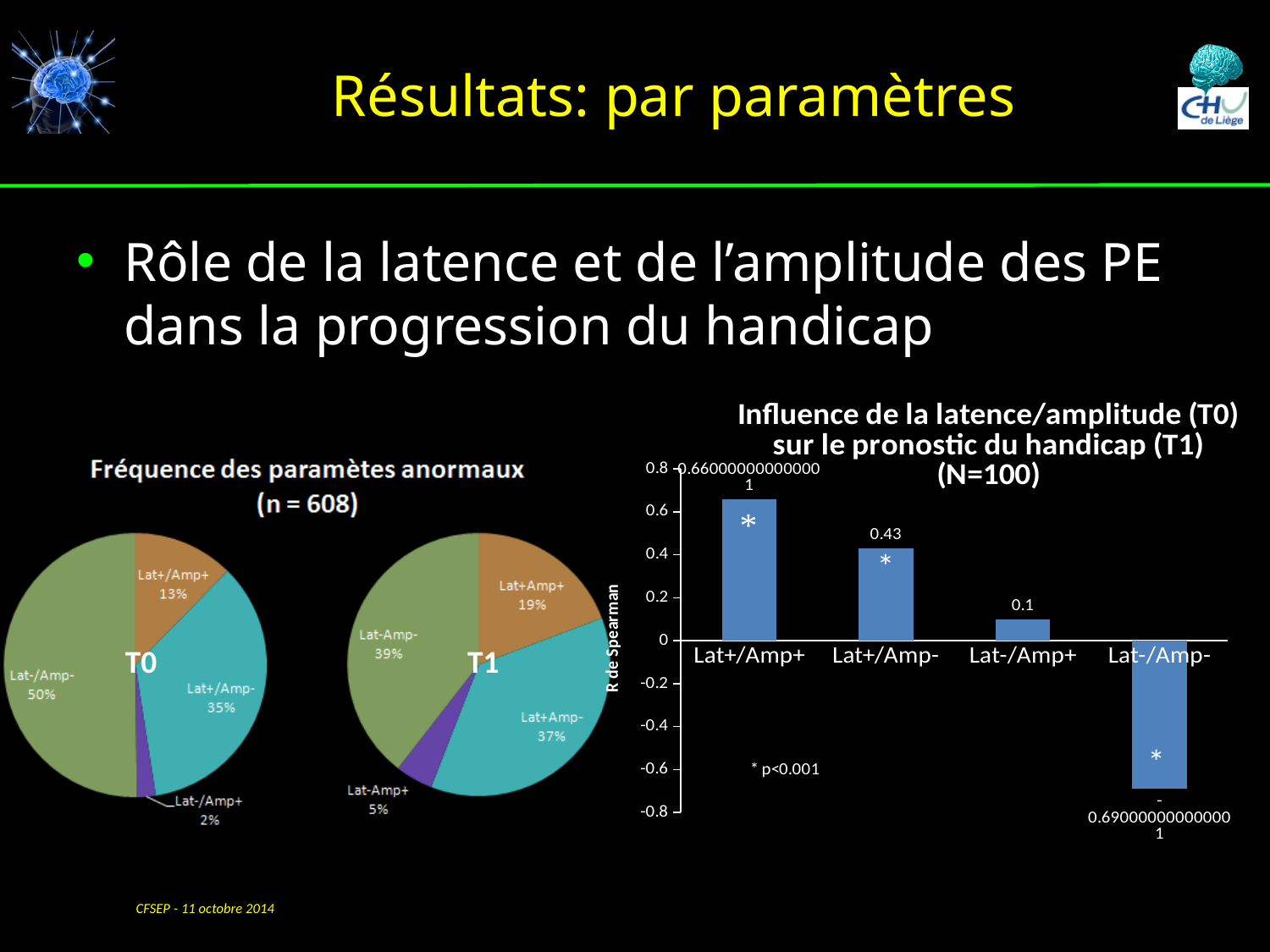
In the T1 pie chart, which category has the largest share? Lat-/Amp- In the bar chart 'Influence de la latence/amplitude (T0) sur le pronostic du handicap (T1)', is the value for Lat+/Amp+ greater or less than 0.6? greater How many slices does the T0 pie chart have? 4 What is the difference between the Lat+/Amp- share in the T1 pie chart and the Lat+/Amp- share in the T0 pie chart? 2% In the bar chart 'Influence de la latence/amplitude (T0) sur le pronostic du handicap (T1)', what is the value for Lat+/Amp-? 0.43 In the T0 pie chart, which category has the smallest share? Lat-/Amp+ In the T1 pie chart, what percentage is shown for Lat+/Amp+? 19% In the T0 pie chart, what percentage is shown for Lat-/Amp-? 50% In the T1 pie chart, which is larger: the Lat+/Amp+ slice or the Lat-/Amp+ slice? Lat+/Amp+ In the bar chart 'Influence de la latence/amplitude (T0) sur le pronostic du handicap (T1)', what is the value for Lat-/Amp+? 0.1 In the bar chart 'Influence de la latence/amplitude (T0) sur le pronostic du handicap (T1)', which category has the lowest value? Lat-/Amp- What type of chart is the chart titled 'Influence de la latence/amplitude (T0) sur le pronostic du handicap (T1)'? bar chart